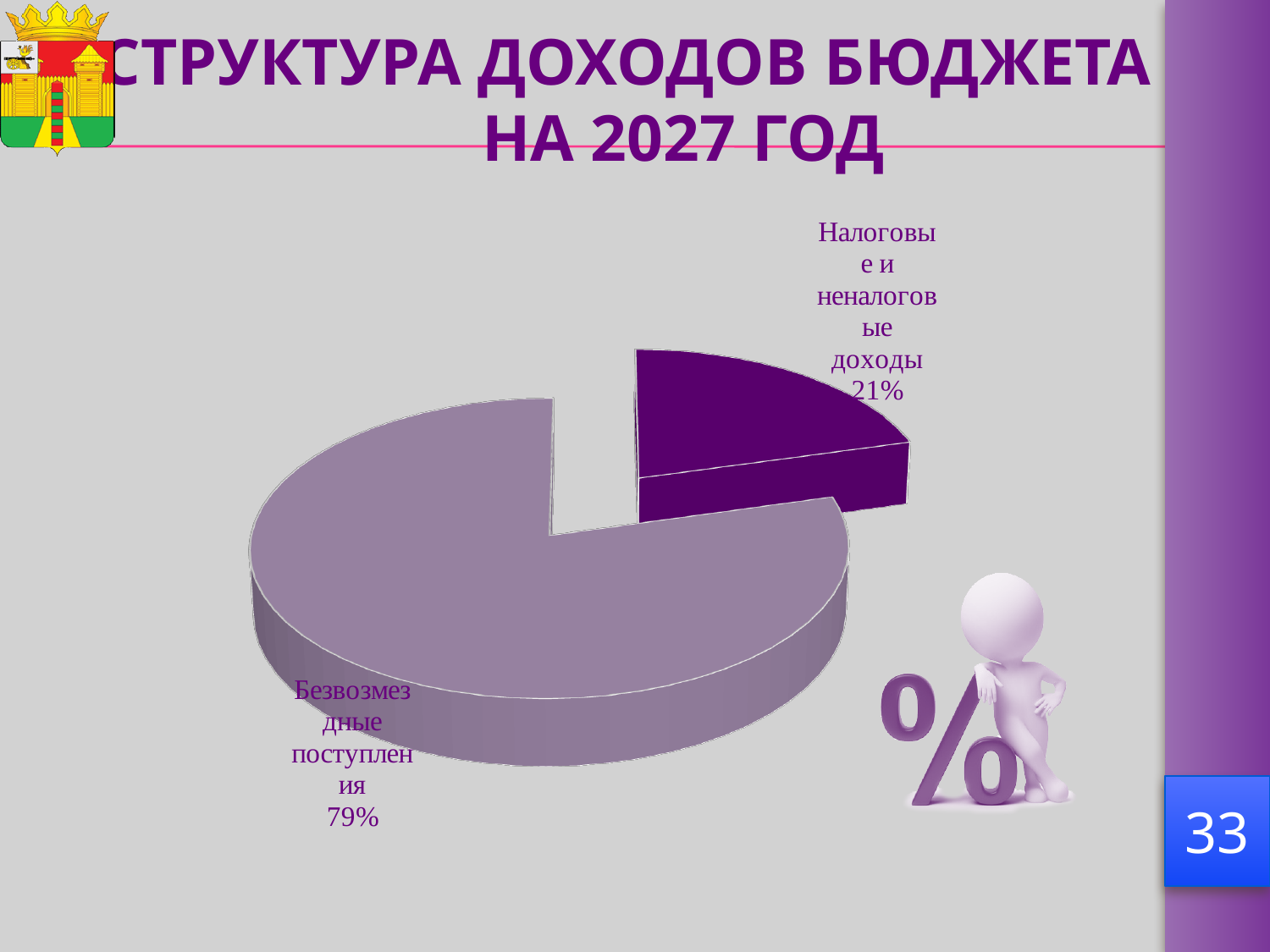
Which slice of the pie is the largest? Безвозмездные поступления What kind of chart is shown on the slide? pie chart How many slices does the pie chart have? 2 Which is larger: "Налоговые и неналоговые доходы" or "Безвозмездные поступления"? Безвозмездные поступления What share of the pie does "Безвозмездные поступления" have? 79% What is the title of the slide containing the pie chart? СТРУКТУРА ДОХОДОВ БЮДЖЕТА НА 2027 ГОД What share of the pie does "Налоговые и неналоговые доходы" have? 21% What is the total of the two pie slice percentages? 100% Which slice of the pie is the smallest? Налоговые и неналоговые доходы Which slice is pulled out (exploded) from the rest of the pie? Налоговые и неналоговые доходы What is the difference in percentage points between "Безвозмездные поступления" and "Налоговые и неналоговые доходы"? 58